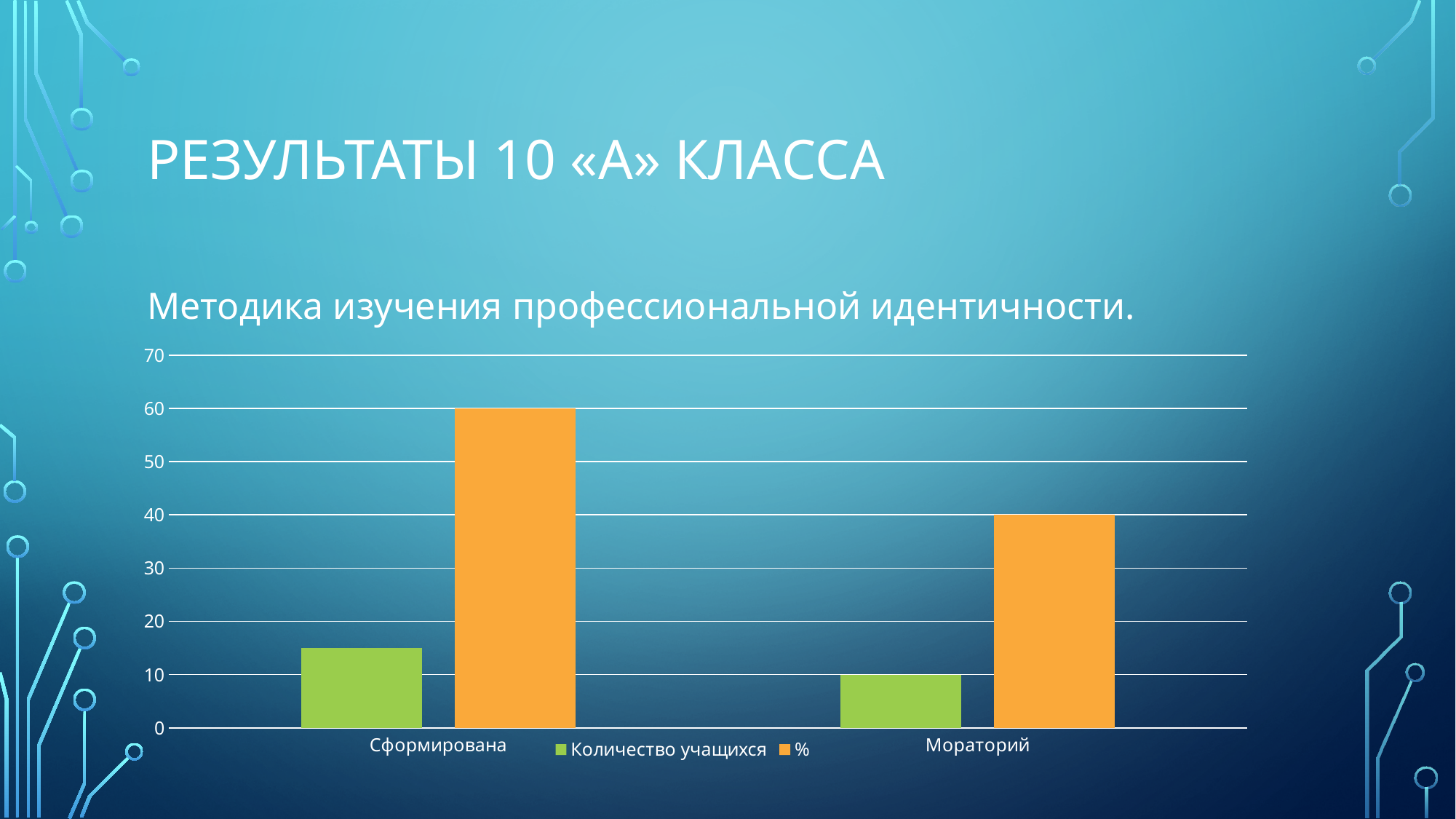
What is the value of Количество учащихся for Мораторий? 10 What kind of chart is shown on the slide? bar chart Which category has the higher % value? Сформирована Is the Количество учащихся value for Сформирована greater or less than 20? less Which series is shown in orange in the legend? % What is the difference between the % values for Сформирована and Мораторий? 20 Which is larger: Количество учащихся for Сформирована or Количество учащихся for Мораторий? Сформирована What is the value of the % series for Сформирована? 60 What is the value of the % series for Мораторий? 40 How many categories are shown on the x axis? 2 Which category has the lower Количество учащихся value? Мораторий How many series does the legend list? 2